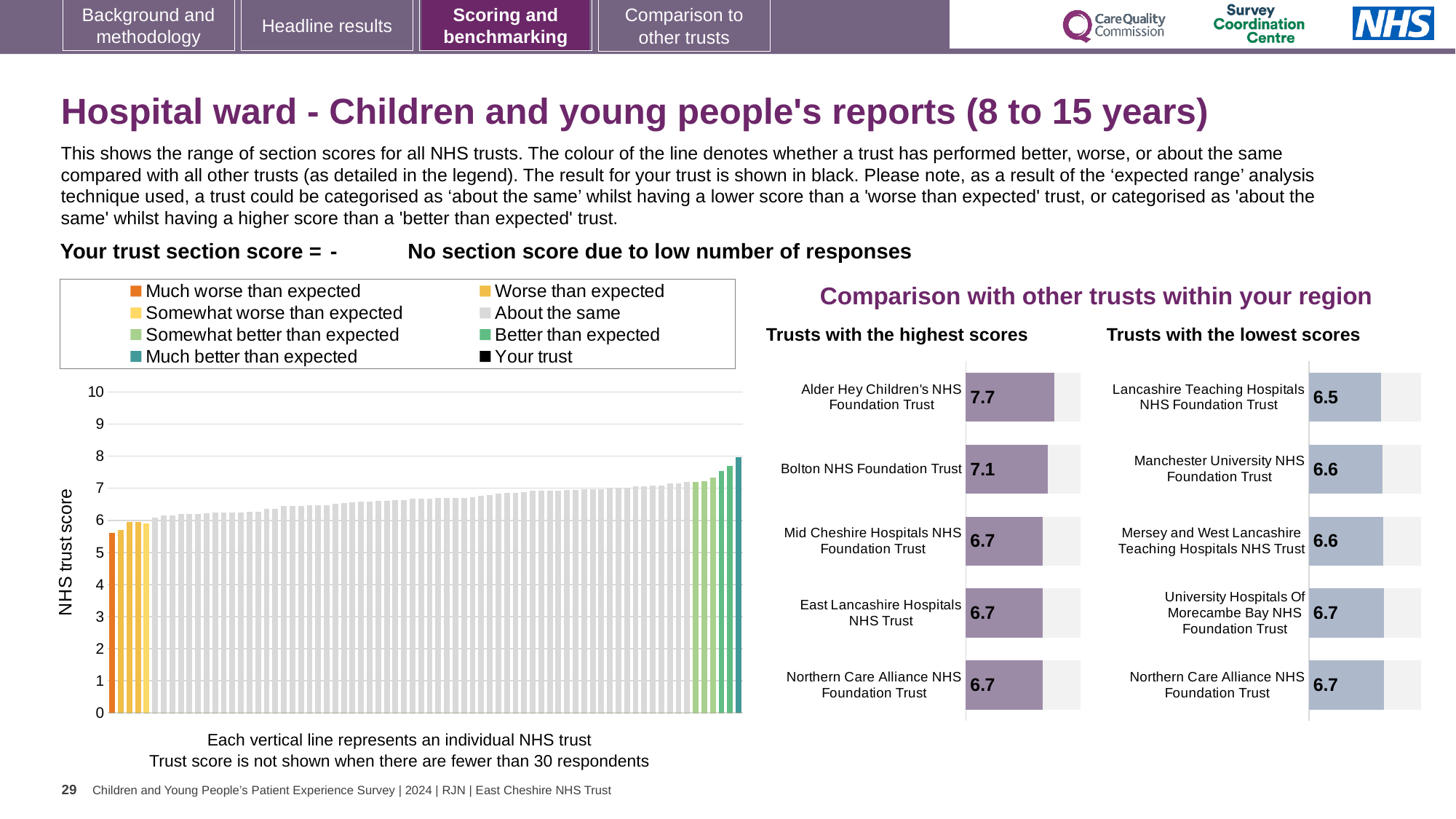
In the 'Trusts with the highest scores' chart, which trust has the highest score? Alder Hey Children's NHS Foundation Trust What is the y-axis label of the left-hand chart? NHS trust score In the 'Trusts with the highest scores' chart, what is the score for Bolton NHS Foundation Trust? 7.1 In the 'Trusts with the lowest scores' chart, which trust has the lowest score? Lancashire Teaching Hospitals NHS Foundation Trust In the 'Trusts with the highest scores' chart, what is the difference between the scores of Alder Hey Children's NHS Foundation Trust and Bolton NHS Foundation Trust? 0.6 In the 'Trusts with the lowest scores' chart, what is the score for Lancashire Teaching Hospitals NHS Foundation Trust? 6.5 How many trusts are listed in the 'Trusts with the lowest scores' chart? 5 In the 'Trusts with the lowest scores' chart, which has the higher score: Manchester University NHS Foundation Trust or University Hospitals Of Morecambe Bay NHS Foundation Trust? University Hospitals Of Morecambe Bay NHS Foundation Trust In the 'Trusts with the highest scores' chart, what is the score for Alder Hey Children's NHS Foundation Trust? 7.7 In the left-hand NHS trust score chart, is the value of the tallest bar greater or less than 9? less What kind of chart is the large chart on the left showing NHS trust scores? Bar chart How many entries does the legend of the left-hand NHS trust score chart list? 8